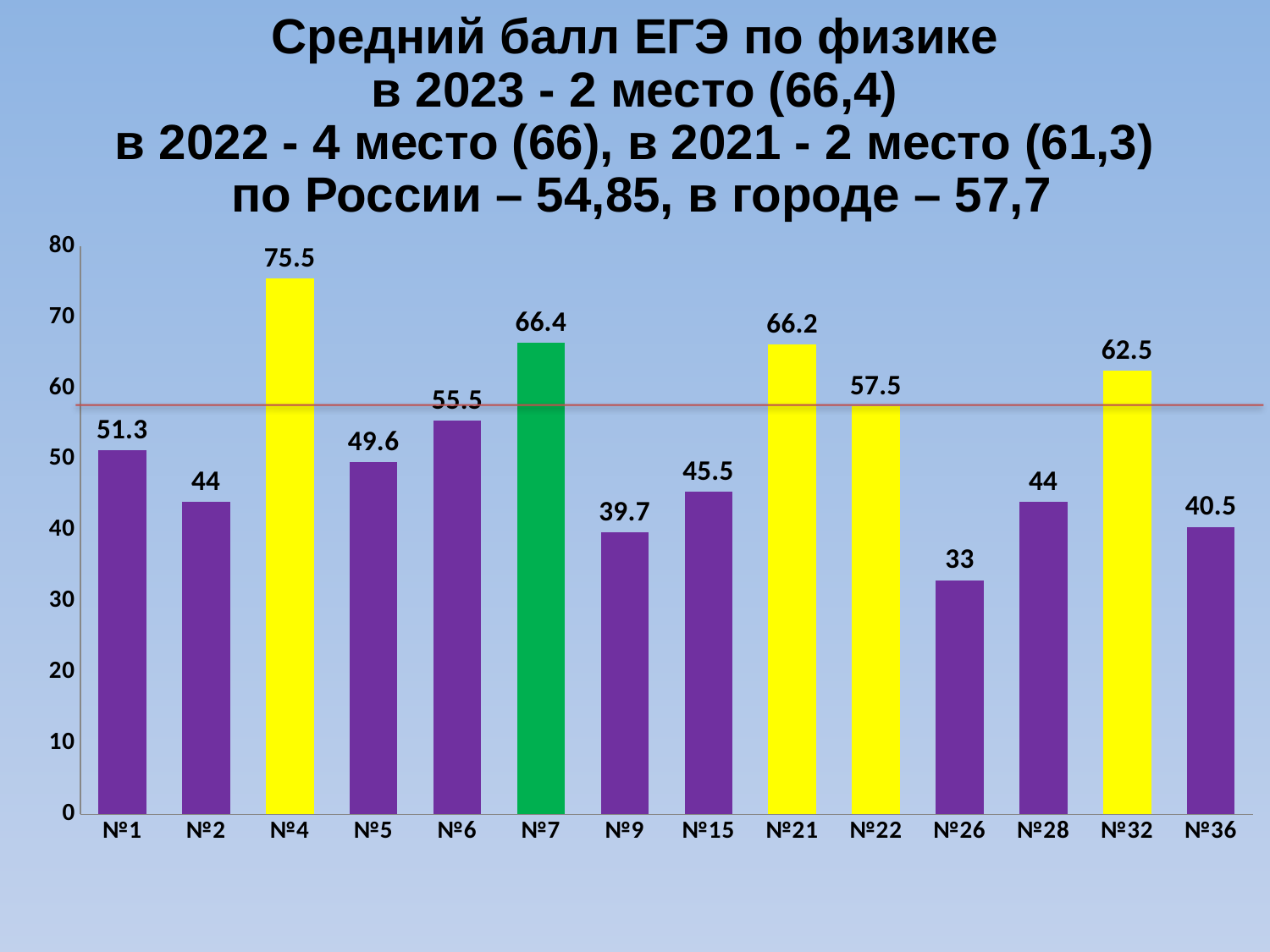
What is the difference between the values for №4 and №7? 9.1 Which is larger, the value for №21 or the value for №32? №21 How many categories are shown on the x axis? 14 What is the value for №4? 75.5 Which category has the lowest value? №26 What colour is the bar for №7? green What is the value for №7? 66.4 What is the value for №26? 33 Is the value for №22 greater or less than 50? greater Which category has the highest value? №4 What is the difference between the values for №1 and №2? 7.3 What kind of chart is shown on the slide? bar chart